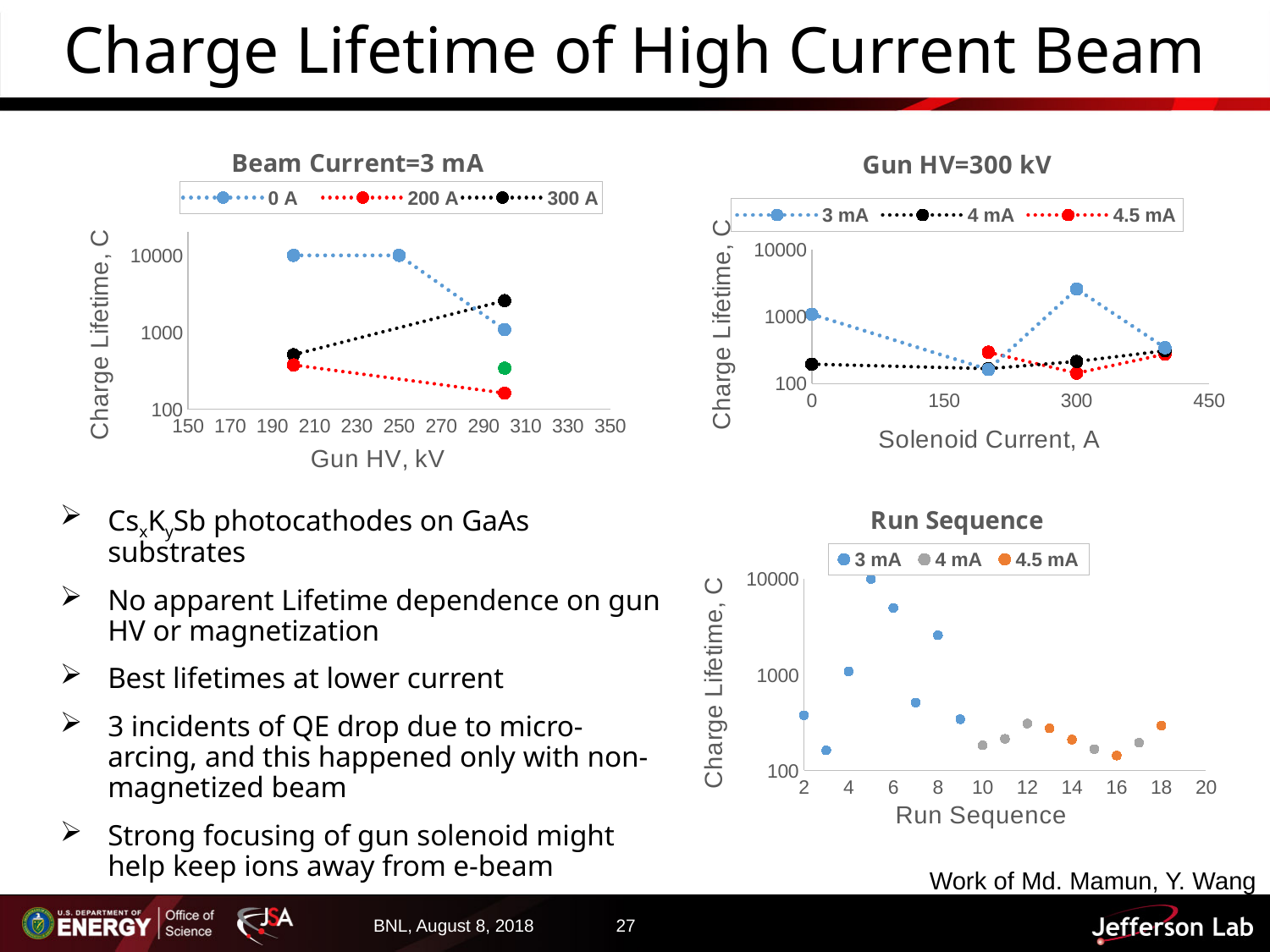
On the 'Run Sequence' chart, is the value at run sequence 3 greater or less than 1000? less On the 'Run Sequence' chart, how many 4.5 mA points are plotted? 4 On the 'Gun HV=300 kV' chart, is the value for the 3 mA series at 300 A greater or less than 1000? greater On the 'Run Sequence' chart, at which run sequence number is the charge lifetime highest? 5 On the 'Gun HV=300 kV' chart, at 300 A solenoid current, which series has the larger charge lifetime: 3 mA or 4.5 mA? 3 mA On the 'Gun HV=300 kV' chart, at which solenoid current does the 3 mA series reach its highest charge lifetime? 300 On the 'Beam Current=3 mA' chart, what is the x-axis label? Gun HV, kV On the 'Beam Current=3 mA' chart, is the value for the 200 A series at 300 kV greater or less than 1000? less On the 'Gun HV=300 kV' chart, what are the three series listed in the legend? 3 mA, 4 mA, 4.5 mA On the 'Beam Current=3 mA' chart, at 300 kV, which series has the larger charge lifetime: 200 A or 300 A? 300 A On the 'Beam Current=3 mA' chart, how many series does the legend list? 3